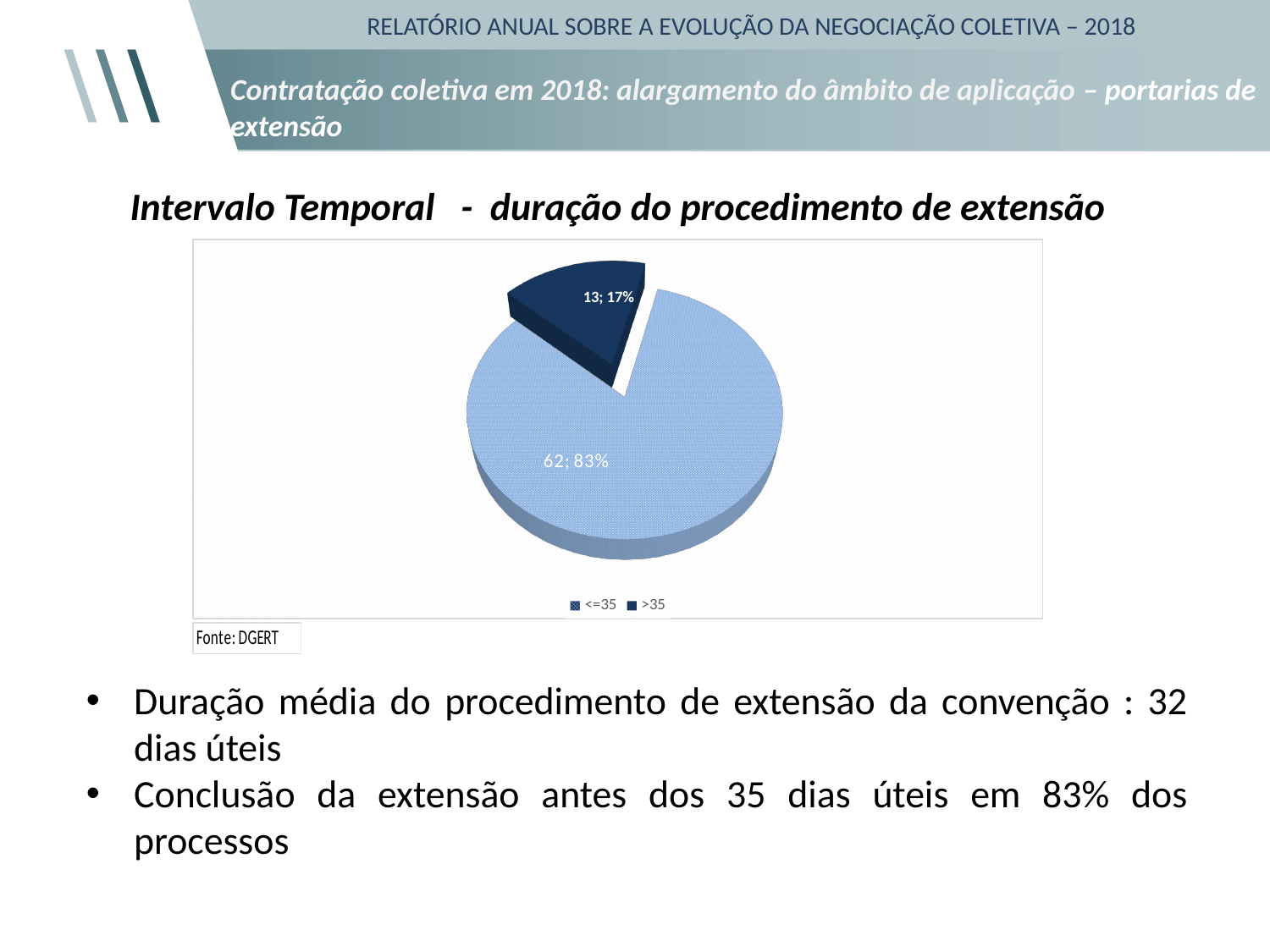
What is the difference between the counts for <=35 and >35? 49 How many slices does the pie chart have? 2 What is the count shown for the <=35 slice? 62 What is the count shown for the >35 slice? 13 What percentage share does the >35 slice represent? 17% What kind of chart is shown on the slide? pie chart Which category has the smallest slice of the pie? >35 Which is larger, the count for <=35 or the count for >35? <=35 Which category has the largest slice of the pie? <=35 What is the total of the two slice counts in the pie chart? 75 How many entries does the legend of the pie chart list? 2 What percentage share does the <=35 slice represent? 83%